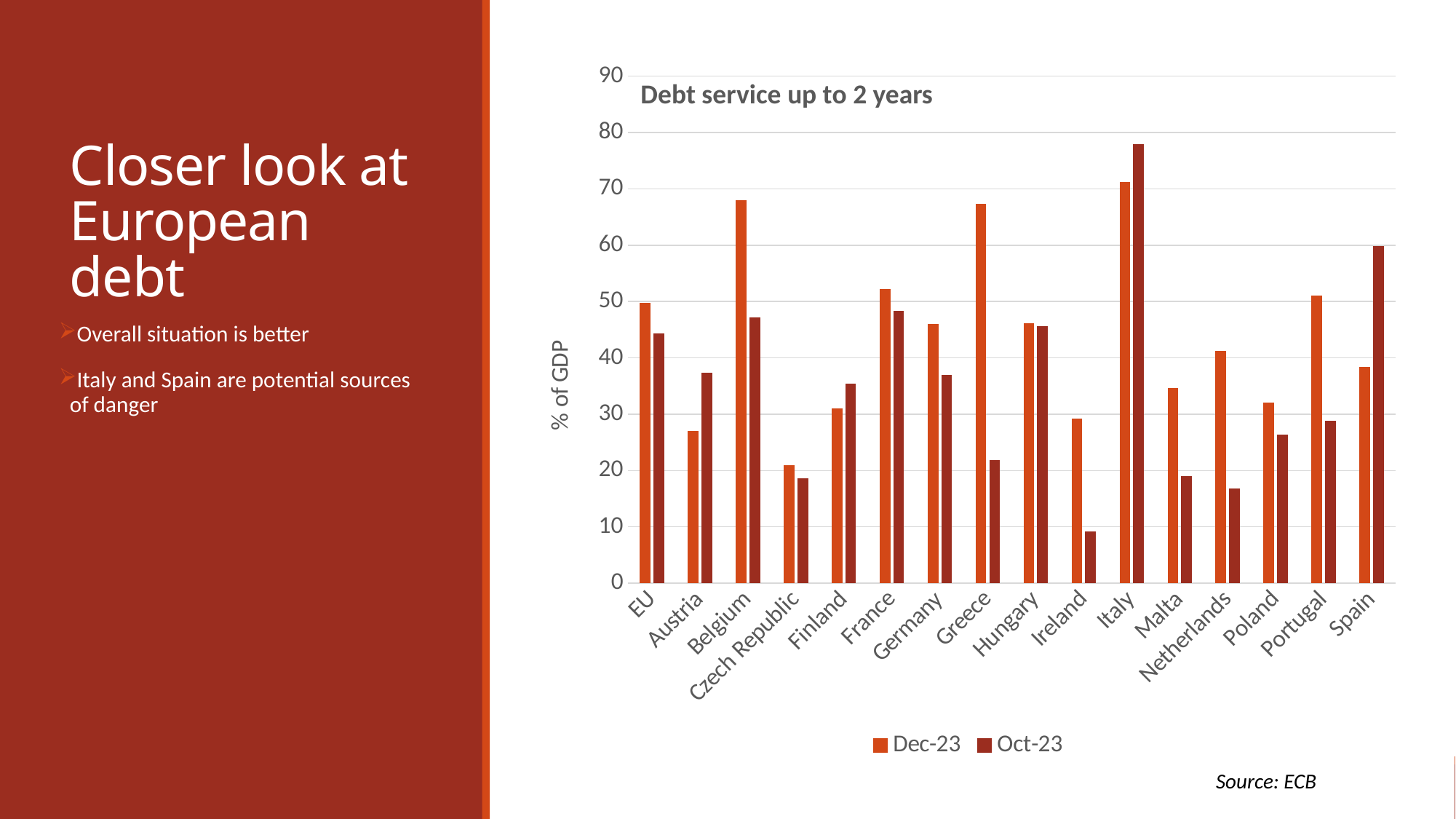
Which category has the lowest Oct-23 value? Ireland What kind of chart is shown on the slide? bar chart Which category has the highest Oct-23 value? Italy Which category has the lowest Dec-23 value? Czech Republic Is the Oct-23 value for Spain greater or less than 50? greater Is the Oct-23 value for Ireland greater or less than 10? less For Greece, which is larger: the Dec-23 value or the Oct-23 value? Dec-23 What is the title of the chart? Debt service up to 2 years How many series does the legend list? 2 Is the Dec-23 value for Belgium greater or less than 60? greater How many countries/regions are shown along the x axis? 16 For Spain, which is larger: the Dec-23 value or the Oct-23 value? Oct-23